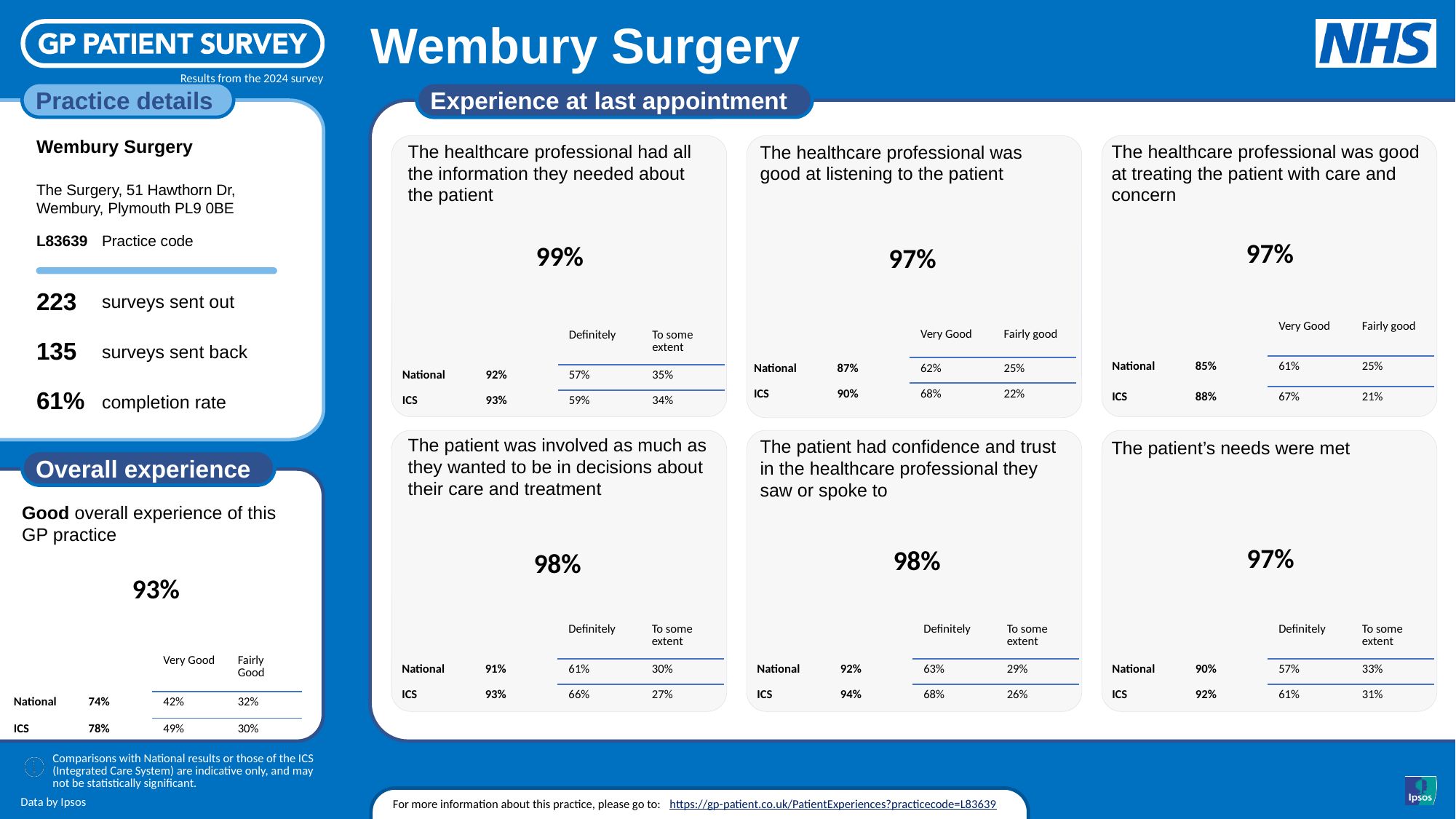
In the 'Overall experience' panel, what is the ICS value for good overall experience? 78% In the panel 'The patient had confidence and trust in the healthcare professional they saw or spoke to', what is the ICS 'Definitely' value? 68% In the 'Overall experience' panel, what is the National value for good overall experience? 74% In the 'Overall experience' panel, which is larger: the National value or the ICS value? ICS In the panel 'The healthcare professional had all the information they needed about the patient', what is the practice's headline percentage? 99% Among the six 'Experience at last appointment' panels, which question has the highest practice headline percentage? The healthcare professional had all the information they needed about the patient In the 'Overall experience' panel, what percentage of patients reported a good overall experience of this GP practice? 93% In the panel 'The healthcare professional was good at listening to the patient', what is the National value? 87% In the panel 'The healthcare professional was good at treating the patient with care and concern', what is the ICS 'Very Good' value? 67% In the 'Practice details' panel, what is the completion rate? 61% How many question panels are shown under the 'Experience at last appointment' heading? 6 In the panel 'The patient's needs were met', what is the difference between the practice's headline percentage and the National value? 7%